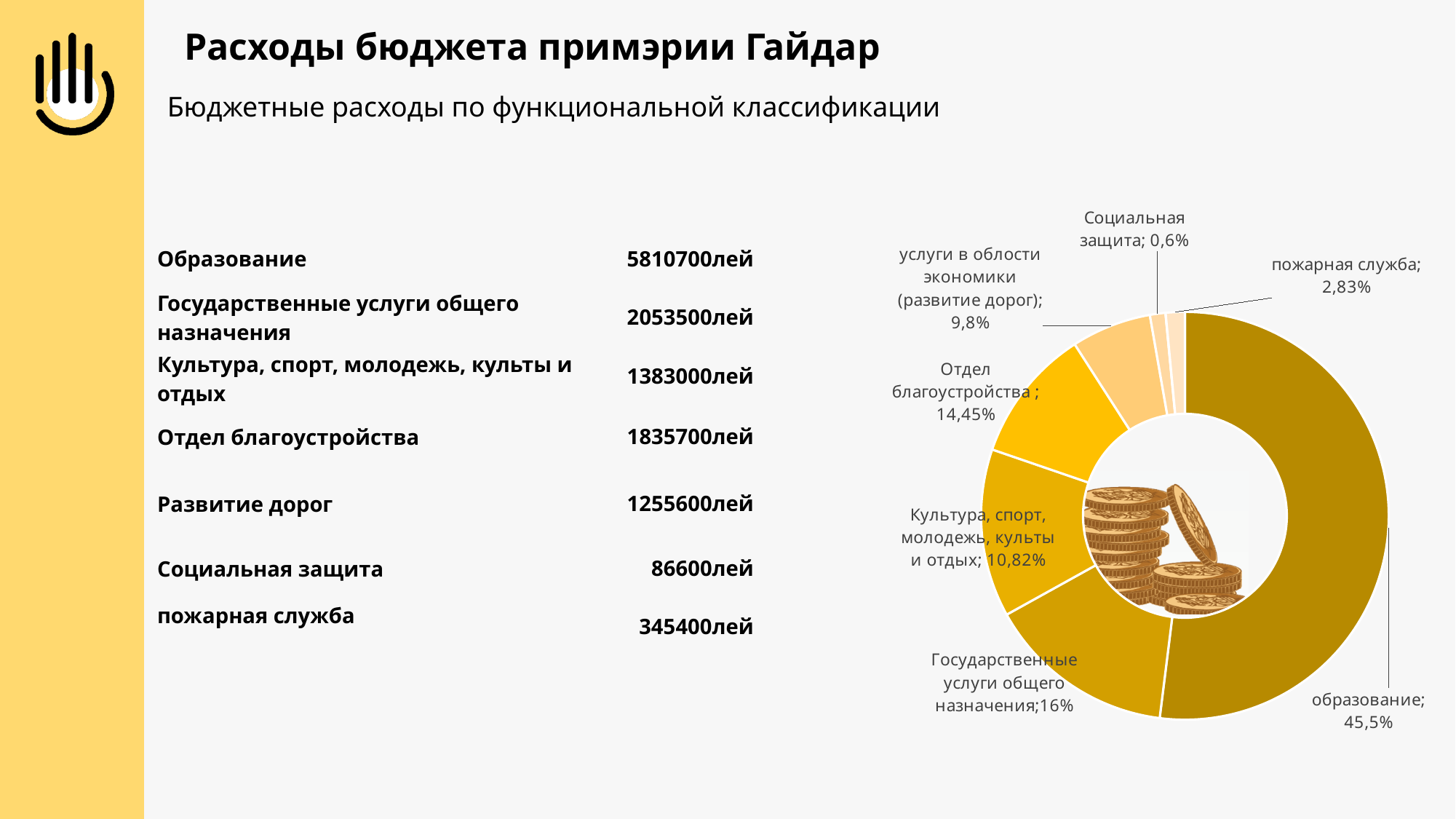
What share of the doughnut chart does образование account for? 45,5% What is the subtitle shown above the chart on the slide? Бюджетные расходы по функциональной классификации How many slices does the chart have? 7 Which category has the smallest slice in the chart? Социальная защита What is the difference in percentage points between услуги в области экономики (развитие дорог) and пожарная служба? 6,97 What percentage is shown for Отдел благоустройства in the chart? 14,45% What is the difference in percentage points between образование and Государственные услуги общего назначения? 29,5 What type of chart is shown on the slide? Doughnut (pie) chart What percentage is shown for Государственные услуги общего назначения in the chart? 16% What percentage is shown for пожарная служба in the chart? 2,83% Which category has the largest slice in the chart? образование Which slice is larger: Отдел благоустройства or Культура, спорт, молодежь, культы и отдых? Отдел благоустройства